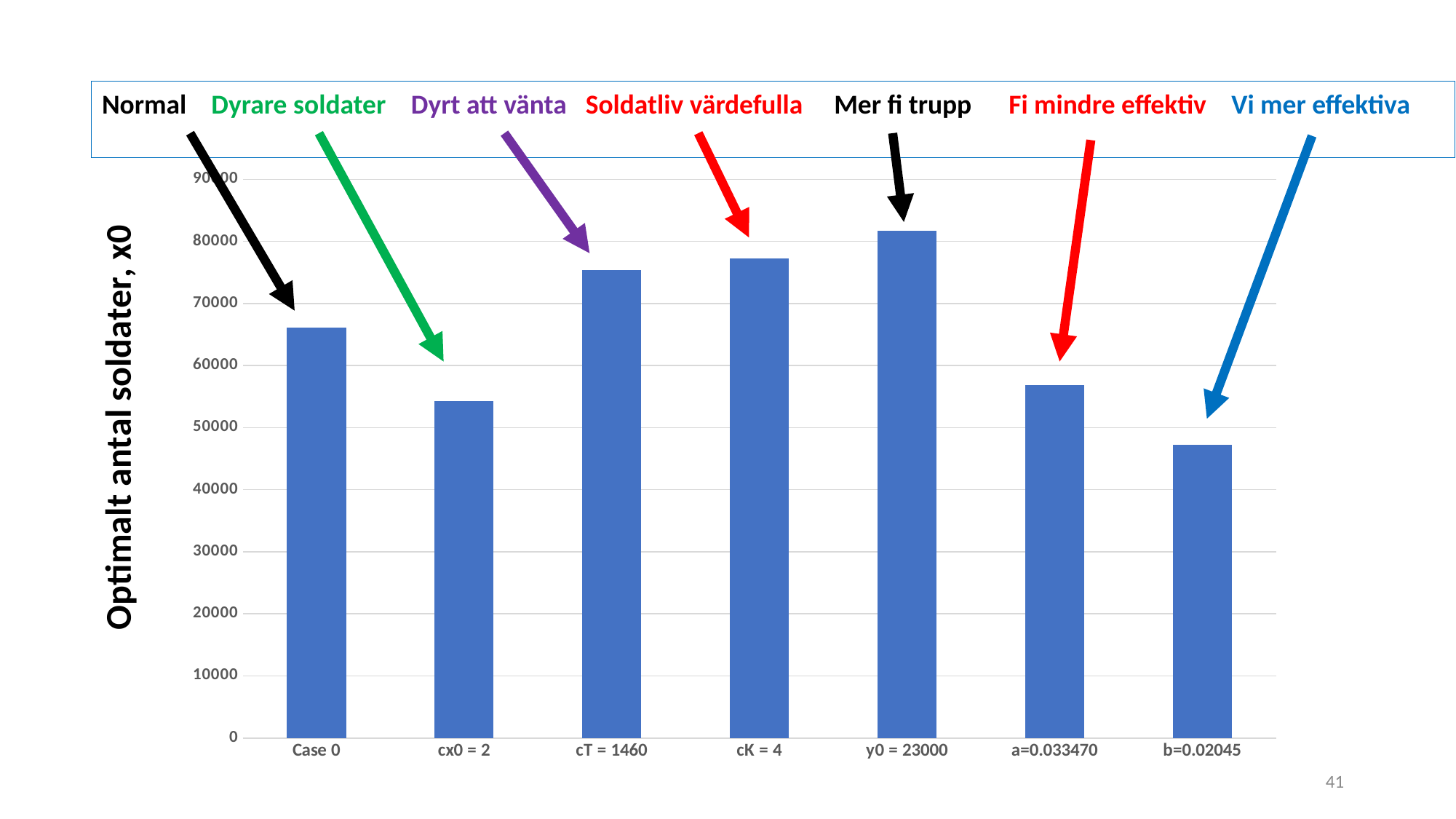
What is the title of the vertical axis? Optimalt antal soldater, x0 Which category has the highest bar? y0 = 23000 How many bars (categories) are plotted in the chart? 7 Which category has the lowest bar? b=0.02045 Is the value for b=0.02045 greater or less than 50000? less Is the value for cT = 1460 greater or less than 70000? greater Which is larger, the value for Case 0 or the value for cx0 = 2? Case 0 Which is larger, the value for y0 = 23000 or the value for b=0.02045? y0 = 23000 Is the value for cx0 = 2 greater or less than 60000? less What kind of chart is shown on the slide? bar chart